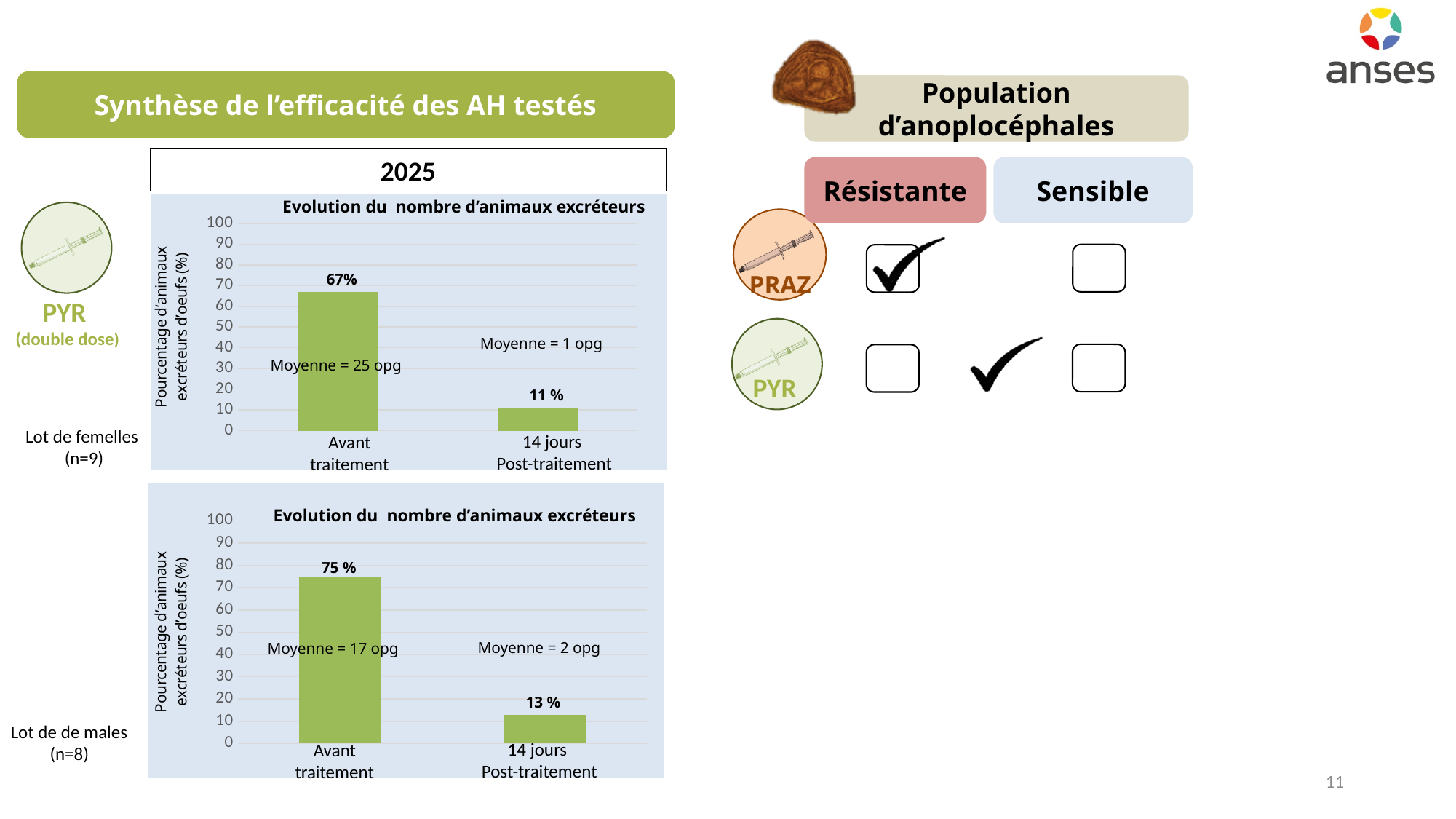
In the bottom chart (Lot de males), what is the value for 'Avant traitement'? 75 % In the top chart (Lot de femelles), what mean egg count (Moyenne) is annotated for '14 jours Post-traitement'? Moyenne = 1 opg In the top chart (Lot de femelles), what is the value for '14 jours Post-traitement'? 11 % What kind of chart is the top chart (Lot de femelles)? Bar chart In the bottom chart (Lot de males), what is the value for '14 jours Post-traitement'? 13 % In the top chart (Lot de femelles), what is the difference between the 'Avant traitement' and '14 jours Post-traitement' values? 56 percentage points Comparing the two charts, which has the larger 'Avant traitement' value: the top chart (Lot de femelles) or the bottom chart (Lot de males)? Bottom chart (Lot de males) How many categories are shown on the x axis of the bottom chart (Lot de males)? 2 In the bottom chart (Lot de males), which category has the lowest value? 14 jours Post-traitement In the top chart (Lot de femelles), what is the value for 'Avant traitement'? 67% In the bottom chart (Lot de males), what is the difference between the 'Avant traitement' and '14 jours Post-traitement' values? 62 percentage points In the top chart (Lot de femelles), which category has the highest value? Avant traitement